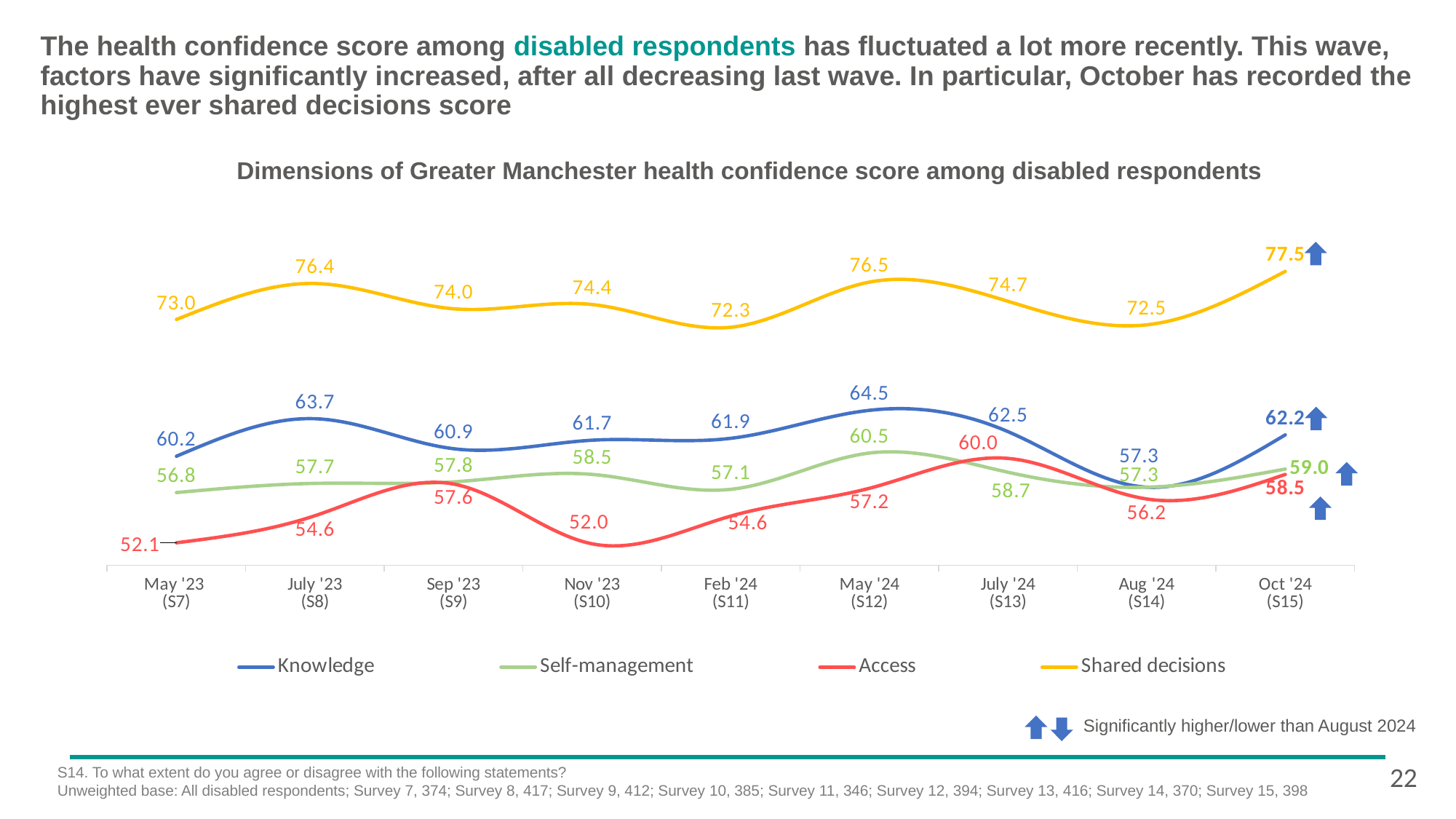
What is the title of the chart? Dimensions of Greater Manchester health confidence score among disabled respondents What is the Self-management score for Aug '24 (S14)? 57.3 In which survey wave is the Shared decisions score highest? Oct '24 (S15) In which survey wave is the Knowledge score lowest? Aug '24 (S14) What type of chart is shown on the slide? Line chart What is the Access score for Nov '23 (S10)? 52.0 How many survey waves are plotted along the x axis? 9 What is the Knowledge score for May '24 (S12)? 64.5 Which is larger in July '24 (S13): the Access score or the Self-management score? Access How many series does the legend list? 4 What is the Shared decisions score for Oct '24 (S15)? 77.5 What is the difference between the Knowledge score in Oct '24 (S15) and Aug '24 (S14)? 4.9